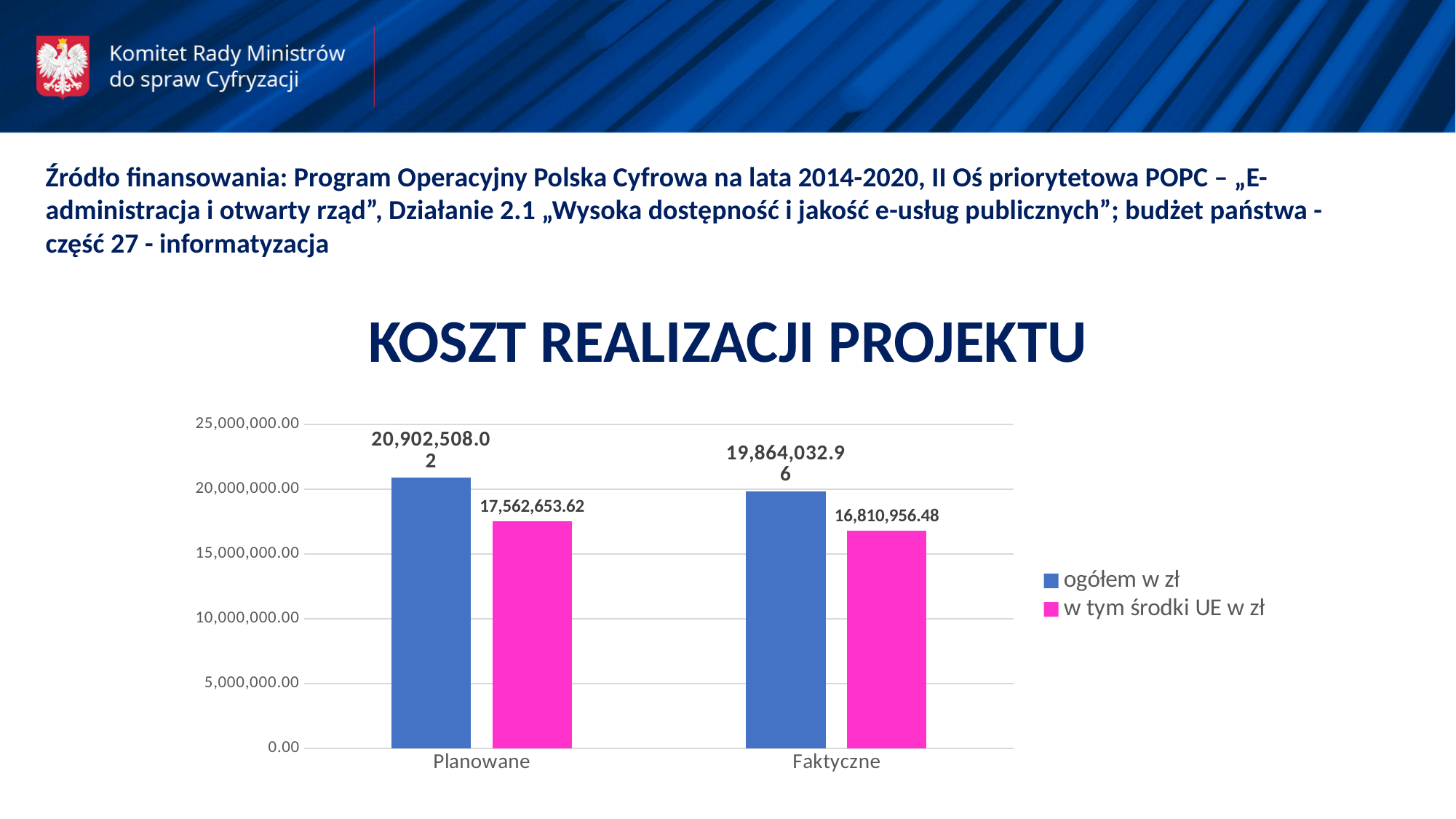
By how much does the "ogółem w zł" value for Planowane exceed that for Faktyczne? 1,038,475.06 Which category has the higher "ogółem w zł" value, Planowane or Faktyczne? Planowane What is the title of the chart? KOSZT REALIZACJI PROJEKTU What is the difference between "ogółem w zł" and "w tym środki UE w zł" for Planowane? 3,339,854.40 What is the value of "w tym środki UE w zł" for Faktyczne? 16,810,956.48 What is the difference between "ogółem w zł" and "w tym środki UE w zł" for Faktyczne? 3,053,076.48 What is the value of "ogółem w zł" for Planowane? 20,902,508.02 How many categories are shown on the x axis of the chart? 2 What is the value of "ogółem w zł" for Faktyczne? 19,864,032.96 How many series does the legend list? 2 What is the value of "w tym środki UE w zł" for Planowane? 17,562,653.62 What type of chart is shown on the slide? Bar chart